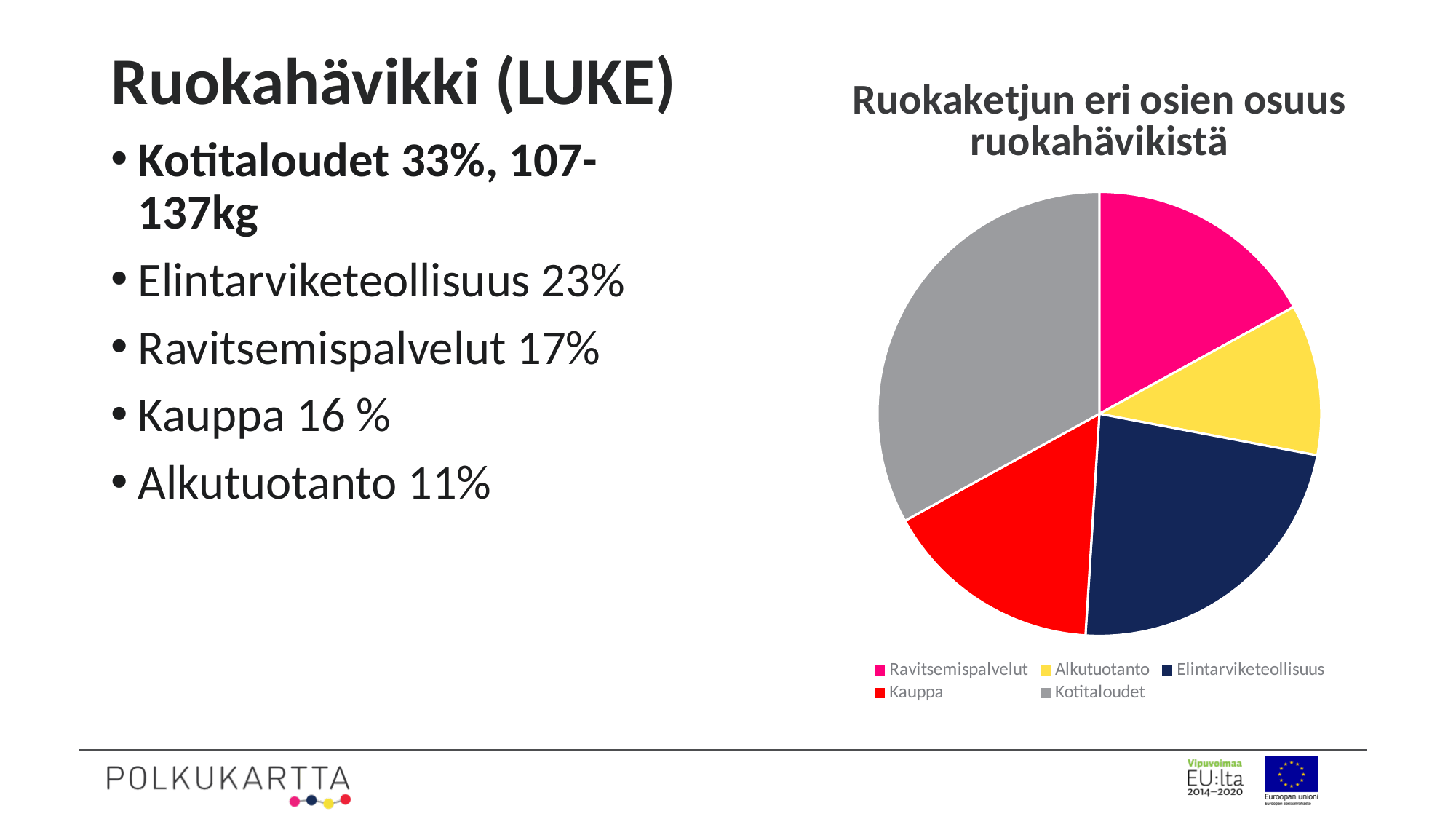
Which category has the largest slice of the pie chart? Kotitaloudet What kind of chart is shown on the slide? pie chart What share of the pie does Kotitaloudet represent? 33% What is the title of the chart? Ruokaketjun eri osien osuus ruokahävikistä How many entries does the chart legend list? 5 Which category has the smallest slice of the pie chart? Alkutuotanto How many slices does the pie chart have? 5 Which slice is larger, Elintarviketeollisuus or Ravitsemispalvelut? Elintarviketeollisuus What share of the pie does Elintarviketeollisuus represent? 23% What is the difference between the shares of Kotitaloudet and Alkutuotanto? 22% Which slice is larger, Kotitaloudet or Kauppa? Kotitaloudet What colour is the Kauppa slice in the pie chart? red